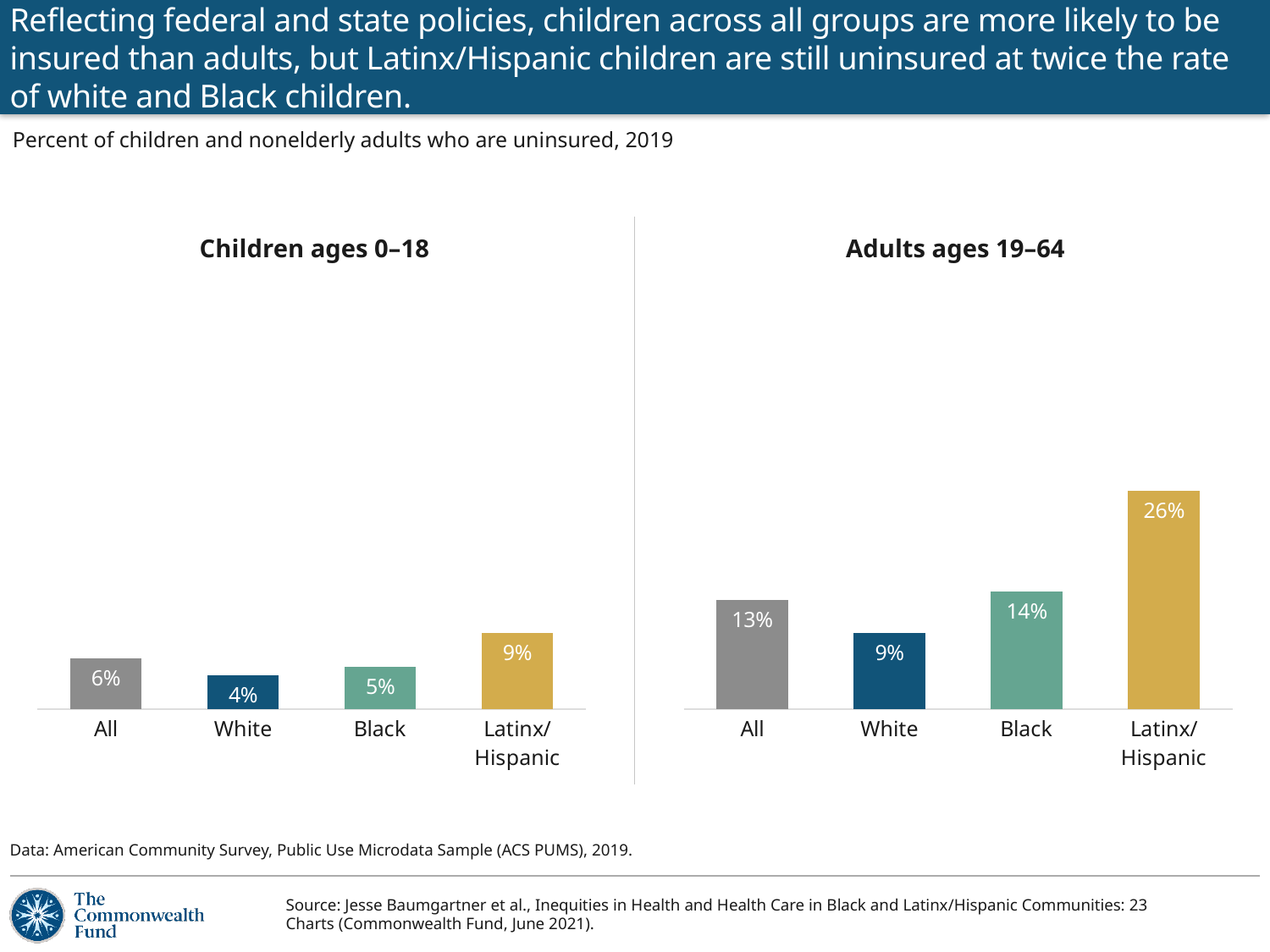
What is the subtitle describing what the charts measure? Percent of children and nonelderly adults who are uninsured, 2019 In the 'Children ages 0–18' chart, which category has the lowest value? White In the 'Children ages 0–18' chart, how many categories are shown? 4 What type of chart is the 'Adults ages 19–64' chart? Bar chart In the 'Adults ages 19–64' chart, what is the value for All? 13% In the 'Children ages 0–18' chart, what is the difference between the Latinx/Hispanic value and the Black value? 4% Which is larger: the value for Black in the 'Children ages 0–18' chart or the value for Black in the 'Adults ages 19–64' chart? Adults ages 19–64 In the 'Adults ages 19–64' chart, what is the difference between the Latinx/Hispanic value and the White value? 17% In the 'Children ages 0–18' chart, what is the value for White? 4% In the 'Children ages 0–18' chart, what is the value for Latinx/Hispanic? 9% In the 'Adults ages 19–64' chart, which category has the highest value? Latinx/Hispanic In the 'Adults ages 19–64' chart, what is the value for Black? 14%